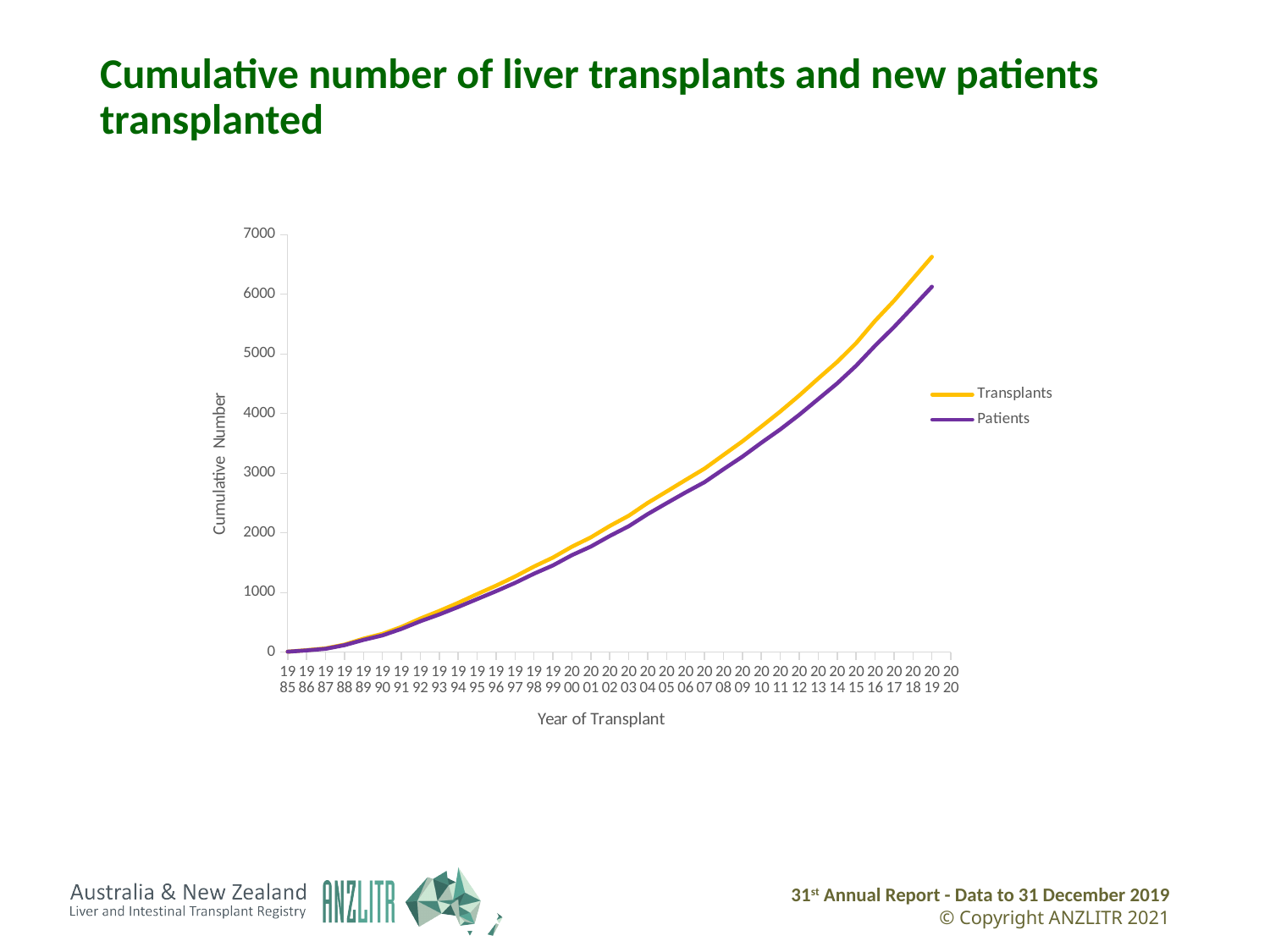
Is the value for Transplants in 2010 greater or less than 4000? less Is the value for Transplants in 2019 greater or less than 6000? greater Is the value for Patients in 2019 greater or less than 5000? greater What is the label of the y axis? Cumulative Number How many years are labelled on the x axis? 36 In 2019, which series has the larger value, Transplants or Patients? Transplants How many series does the legend list? 2 Which two series are listed in the legend? Transplants and Patients What kind of chart is shown on the slide? Line chart Do the values for Transplants rise or fall from 1985 to 2019? Rise